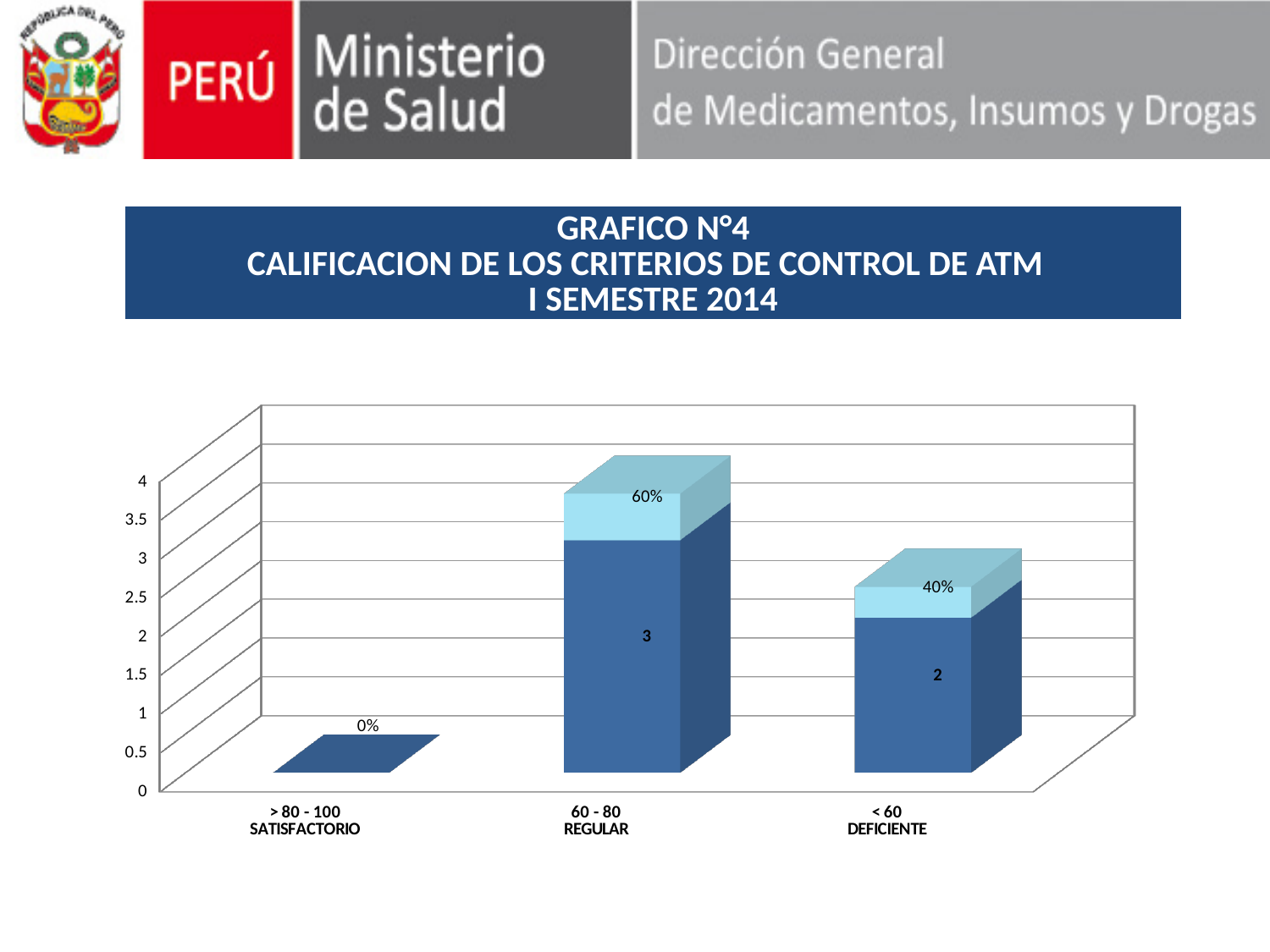
What percentage is shown for the 60 - 80 REGULAR category? 60% What is the value shown for the < 60 DEFICIENTE category? 2 What percentage is shown for the < 60 DEFICIENTE category? 40% Which category has the lowest value? > 80 - 100 SATISFACTORIO How many categories are shown on the x axis of the chart? 3 What is the value shown for the 60 - 80 REGULAR category? 3 What is the difference between the values for 60 - 80 REGULAR and < 60 DEFICIENTE? 1 Which category has the highest value? 60 - 80 REGULAR What kind of chart is shown on the slide? Bar chart What percentage is shown for the > 80 - 100 SATISFACTORIO category? 0% What is the title of the chart on the slide? GRAFICO N°4 CALIFICACION DE LOS CRITERIOS DE CONTROL DE ATM I SEMESTRE 2014 Which is larger, the value for 60 - 80 REGULAR or the value for < 60 DEFICIENTE? 60 - 80 REGULAR